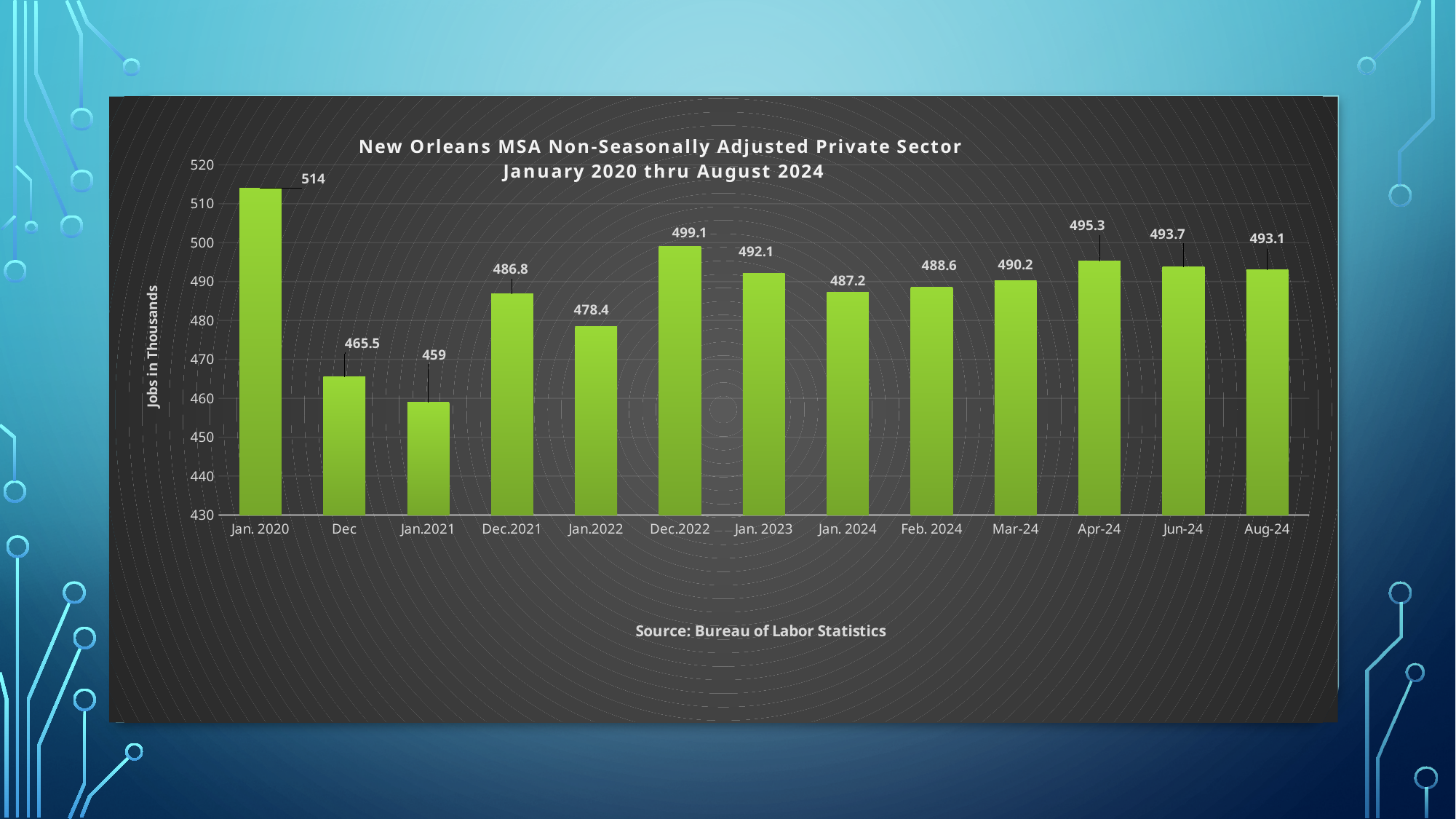
Is the value for Dec greater or less than 470? less What is the value for Dec.2022? 499.1 What is the difference between the values for Apr-24 and Aug-24? 2.2 What is the y-axis label of the chart? Jobs in Thousands What is the value for Aug-24? 493.1 Which category has the lowest value? Jan.2021 How many categories are shown on the x axis? 13 Which category has the highest value? Jan. 2020 What is the difference between the values for Jan. 2020 and Jan.2021? 55 Which is larger, the value for Dec.2021 or the value for Jan.2022? Dec.2021 What kind of chart is shown on the slide? bar chart What is the value for Jan. 2020? 514